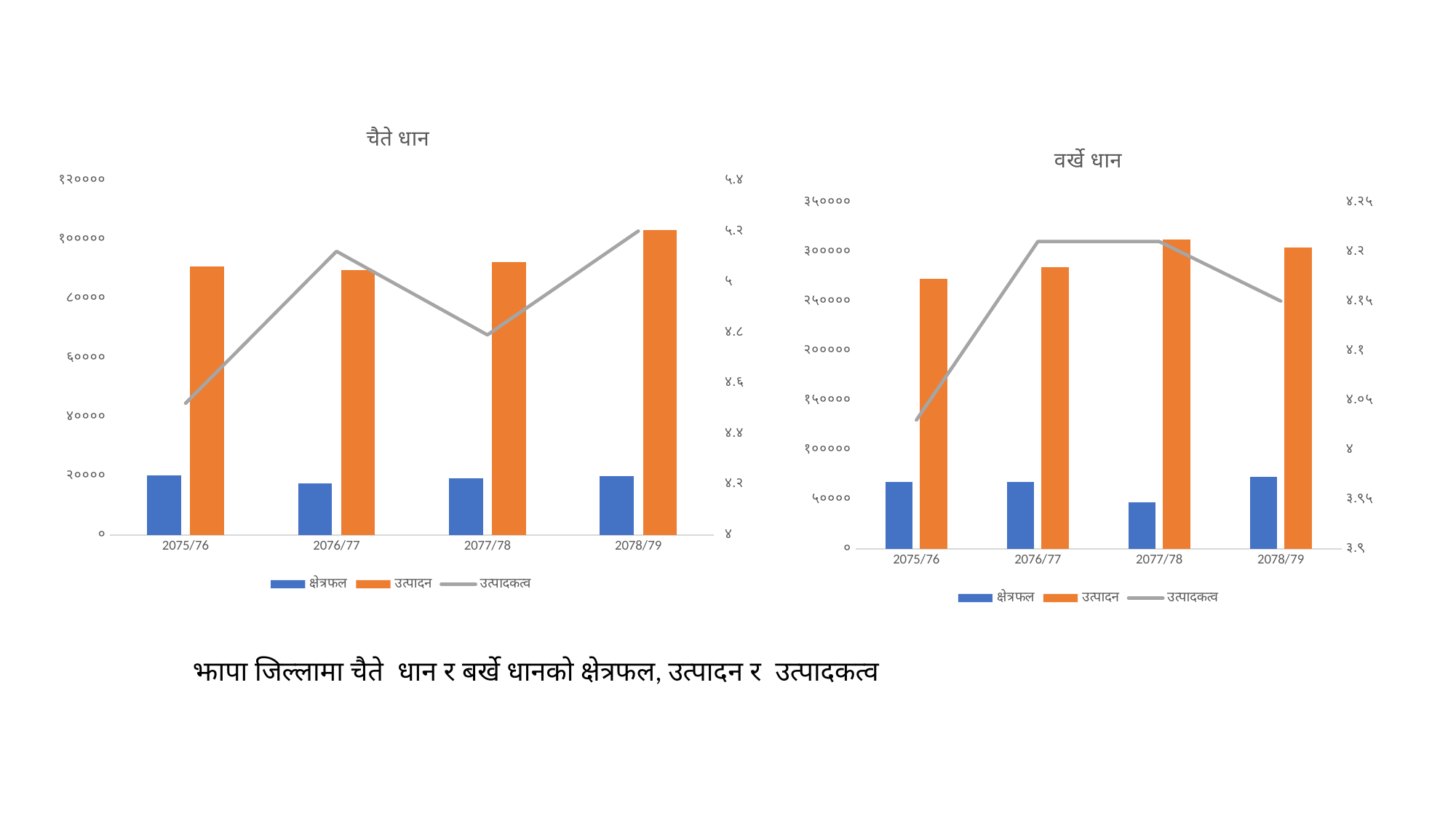
In the वर्खे धान chart, is the उत्पादन value for 2075/76 greater or less than २५००००? greater In the वर्खे धान chart, does the उत्पादकत्व line rise or fall from 2077/78 to 2078/79? fall In the वर्खे धान chart, which is larger, the क्षेत्रफल bar for 2076/77 or for 2077/78? 2076/77 In the वर्खे धान chart, which series is drawn as a line rather than bars? उत्पादकत्व In the वर्खे धान chart, which year has the lowest क्षेत्रफल bar? 2077/78 What kind of chart is the चैते धान chart on the left? bar and line chart In the चैते धान chart, how many series does the legend list? 3 In the चैते धान chart, is the उत्पादन value for 2078/79 greater or less than १०००००? greater In the चैते धान chart, how many years are shown on the x axis? 4 In the चैते धान chart, which year has the highest उत्पादन bar? 2078/79 In the चैते धान chart, is the क्षेत्रफल value for 2076/77 greater or less than २००००? less In the चैते धान chart, which year has the lowest उत्पादकत्व point on the line? 2075/76